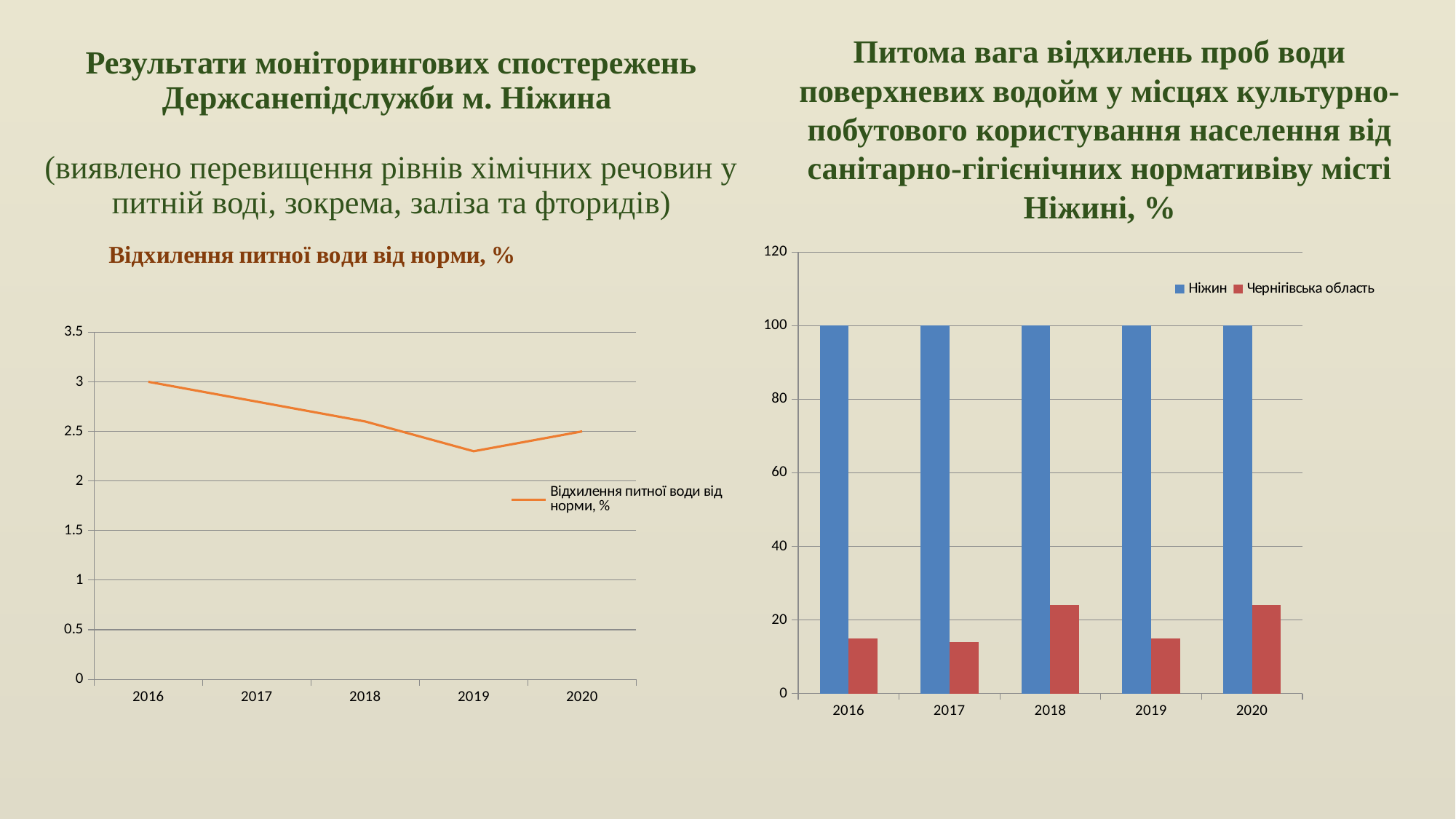
In the right bar chart, what is the value for Ніжин in 2018? 100 In the left chart "Відхилення питної води від норми, %", is the value for 2019 greater or less than 2.5? less In the left chart "Відхилення питної води від норми, %", what is the value for 2016? 3 What kind of chart is the right chart titled "Питома вага відхилень проб води поверхневих водойм..."? bar chart In the right bar chart, which series is larger in 2017, Ніжин or Чернігівська область? Ніжин In the left chart "Відхилення питної води від норми, %", how many years are plotted on the x axis? 5 In the right bar chart, how many series does the legend list? 2 In the left chart "Відхилення питної води від норми, %", which year has the highest value? 2016 In the left chart "Відхилення питної води від норми, %", which year has the lowest value? 2019 In the left chart "Відхилення питної води від норми, %", what is the value for 2020? 2.5 In the right bar chart, is the value for Чернігівська область in 2018 greater or less than 20? greater What kind of chart is the left chart titled "Відхилення питної води від норми, %"? line chart